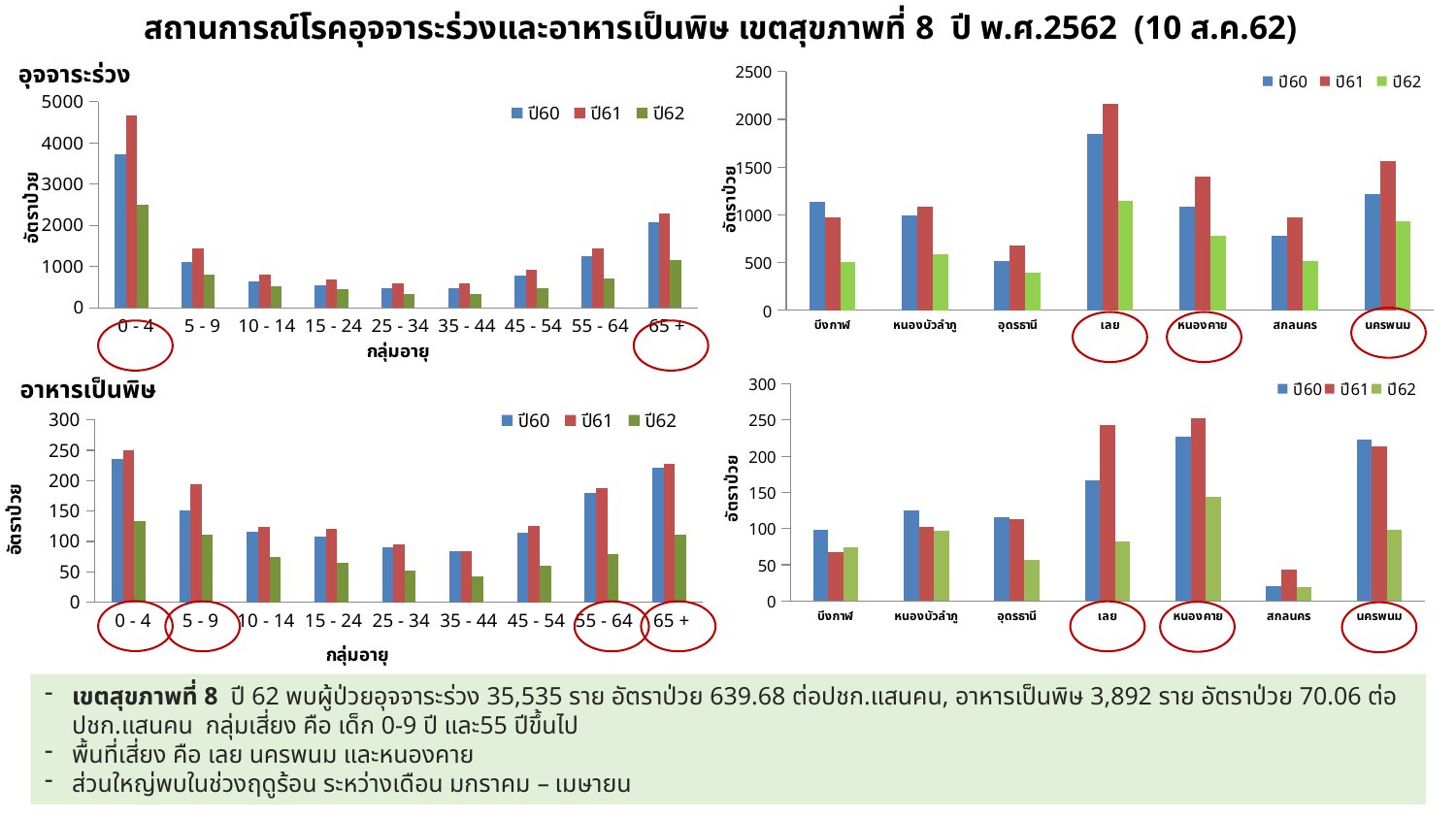
In the top-left chart (อุจจาระร่วง by กลุ่มอายุ), which age group has the highest value for ปี61? 0 - 4 In the bottom-right chart (อาหารเป็นพิษ by province), which is larger for หนองคาย, the ปี60 value or the ปี62 value? ปี60 In the bottom-left chart (อาหารเป็นพิษ by กลุ่มอายุ), which age group has the lowest value for ปี62? 35 - 44 In the top-left chart (อุจจาระร่วง by กลุ่มอายุ), is the ปี61 value for the 0 - 4 age group greater or less than 4000? greater In the bottom-right chart (อาหารเป็นพิษ by province), which province has the lowest value for ปี60? สกลนคร In the top-left chart (อุจจาระร่วง by กลุ่มอายุ), how many series does the legend list? 3 What type of chart is the bottom-right chart (อาหารเป็นพิษ by province)? bar chart In the top-right chart (อุจจาระร่วง by province), which province has the highest value for ปี61? เลย In the top-left chart (อุจจาระร่วง by กลุ่มอายุ), how many age groups are shown on the x axis? 9 In the top-right chart (อุจจาระร่วง by province), is the ปี60 value for เลย greater or less than 1500? greater In the top-right chart (อุจจาระร่วง by province), which has the larger ปี62 value, เลย or นครพนม? เลย In the bottom-left chart (อาหารเป็นพิษ by กลุ่มอายุ), is the ปี61 value for the 0 - 4 age group greater or less than 200? greater